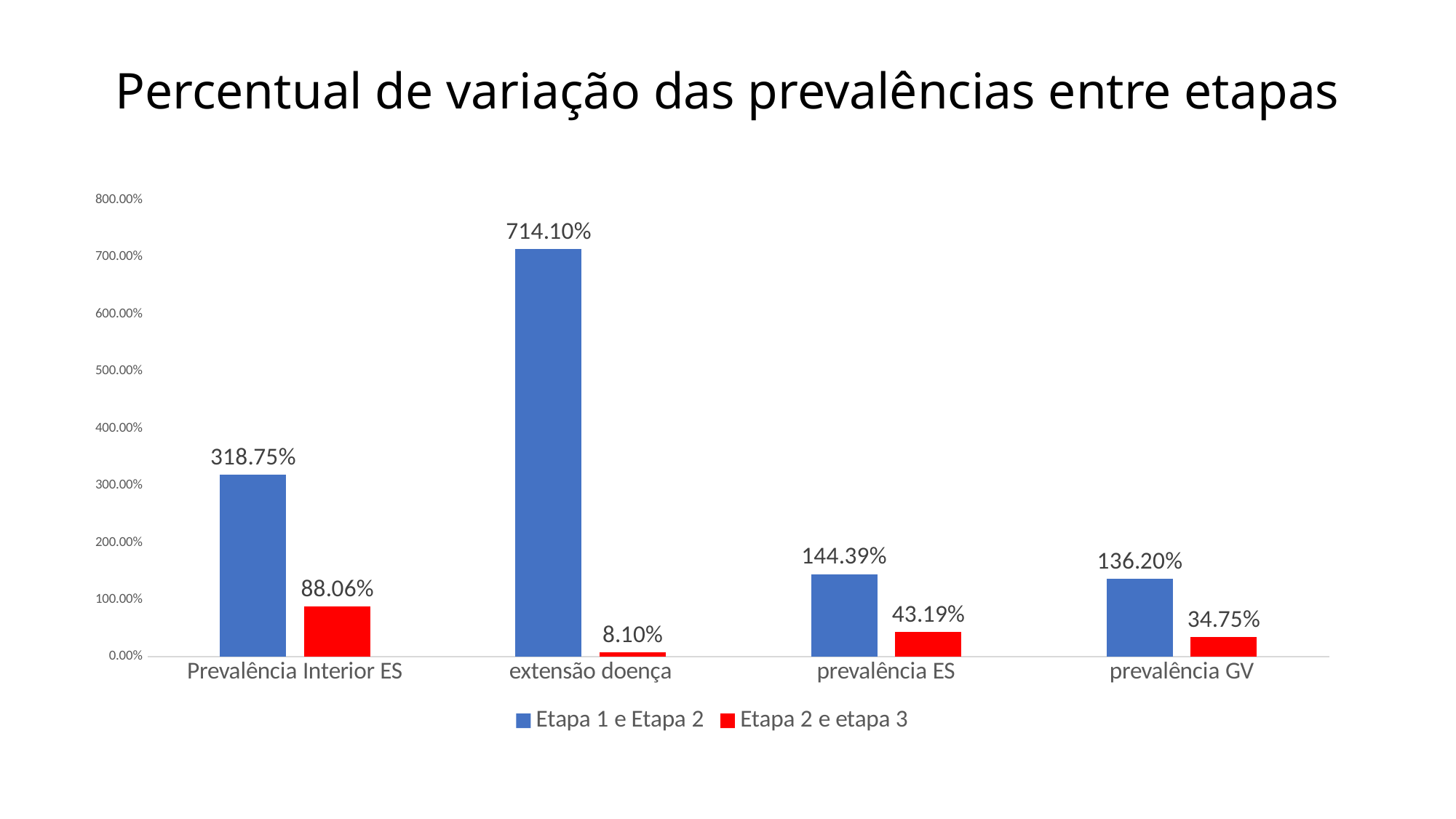
Which is larger: the 'Etapa 1 e Etapa 2' value for 'prevalência ES' or for 'prevalência GV'? prevalência ES Which category has the highest value in the 'Etapa 1 e Etapa 2' series? extensão doença What is the value for 'Prevalência Interior ES' in the 'Etapa 2 e etapa 3' series? 88.06% What is the difference between the 'Etapa 1 e Etapa 2' and 'Etapa 2 e etapa 3' values for 'prevalência ES'? 101.20% Is the 'Etapa 1 e Etapa 2' value for 'Prevalência Interior ES' greater or less than 300.00%? greater What is the value for 'prevalência GV' in the 'Etapa 2 e etapa 3' series? 34.75% How many categories are shown on the x axis? 4 How many series does the legend list? 2 What kind of chart is shown on the slide? bar chart What is the value for 'extensão doença' in the 'Etapa 1 e Etapa 2' series? 714.10% Which category has the lowest value in the 'Etapa 2 e etapa 3' series? extensão doença What is the title of the chart? Percentual de variação das prevalências entre etapas